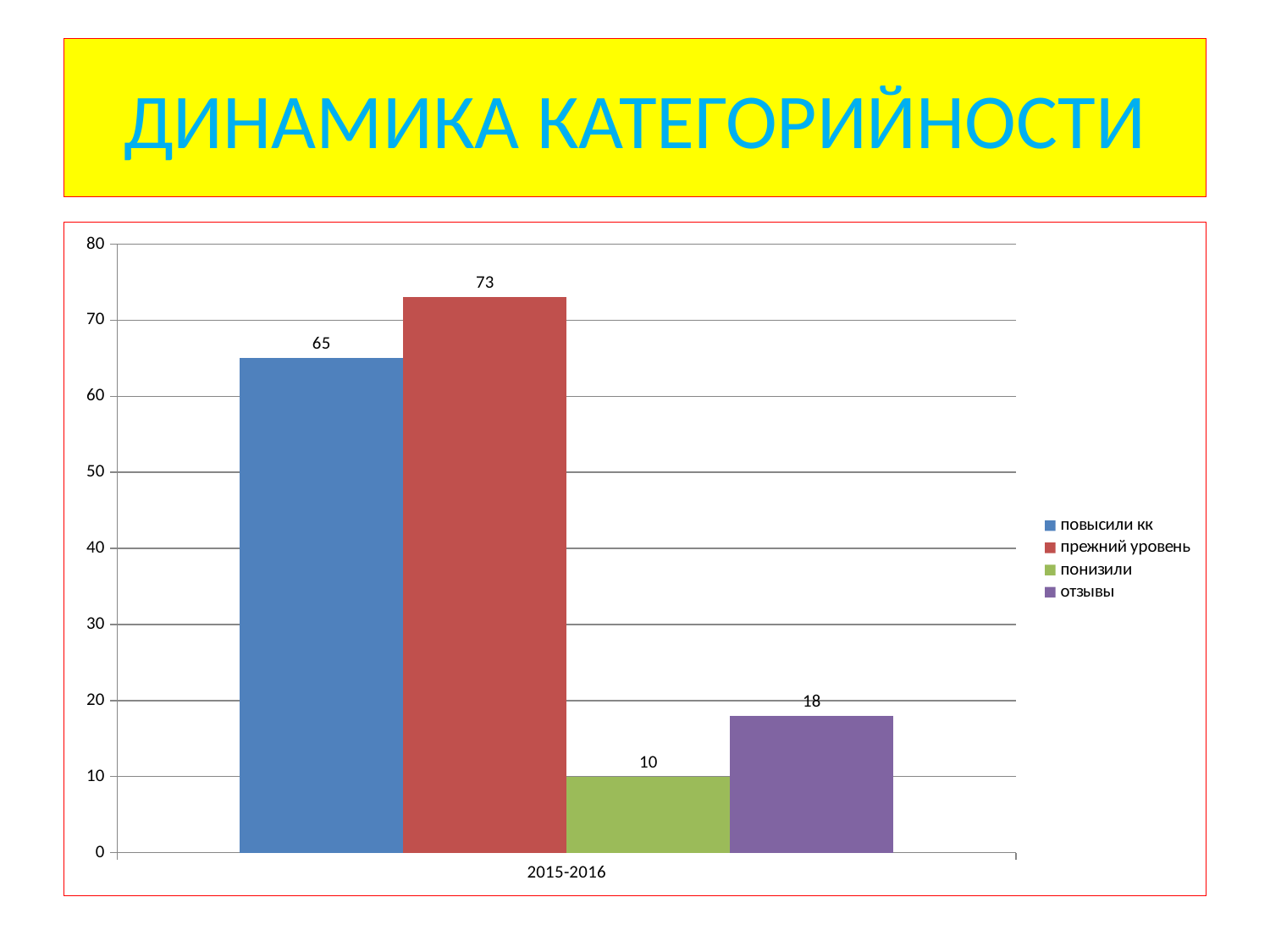
What kind of chart is shown on the slide? bar chart What is the value for "понизили" in 2015-2016? 10 What is the value for "отзывы" in 2015-2016? 18 Which series has the lowest value? понизили How many series does the legend list? 4 Which is larger, the value for "отзывы" or the value for "понизили"? отзывы What is the value for "повысили кк" in 2015-2016? 65 Which series has the highest value? прежний уровень What is the title of the slide? ДИНАМИКА КАТЕГОРИЙНОСТИ What is the difference between the values for "прежний уровень" and "повысили кк"? 8 What is the difference between the values for "отзывы" and "понизили"? 8 What is the value for "прежний уровень" in 2015-2016? 73